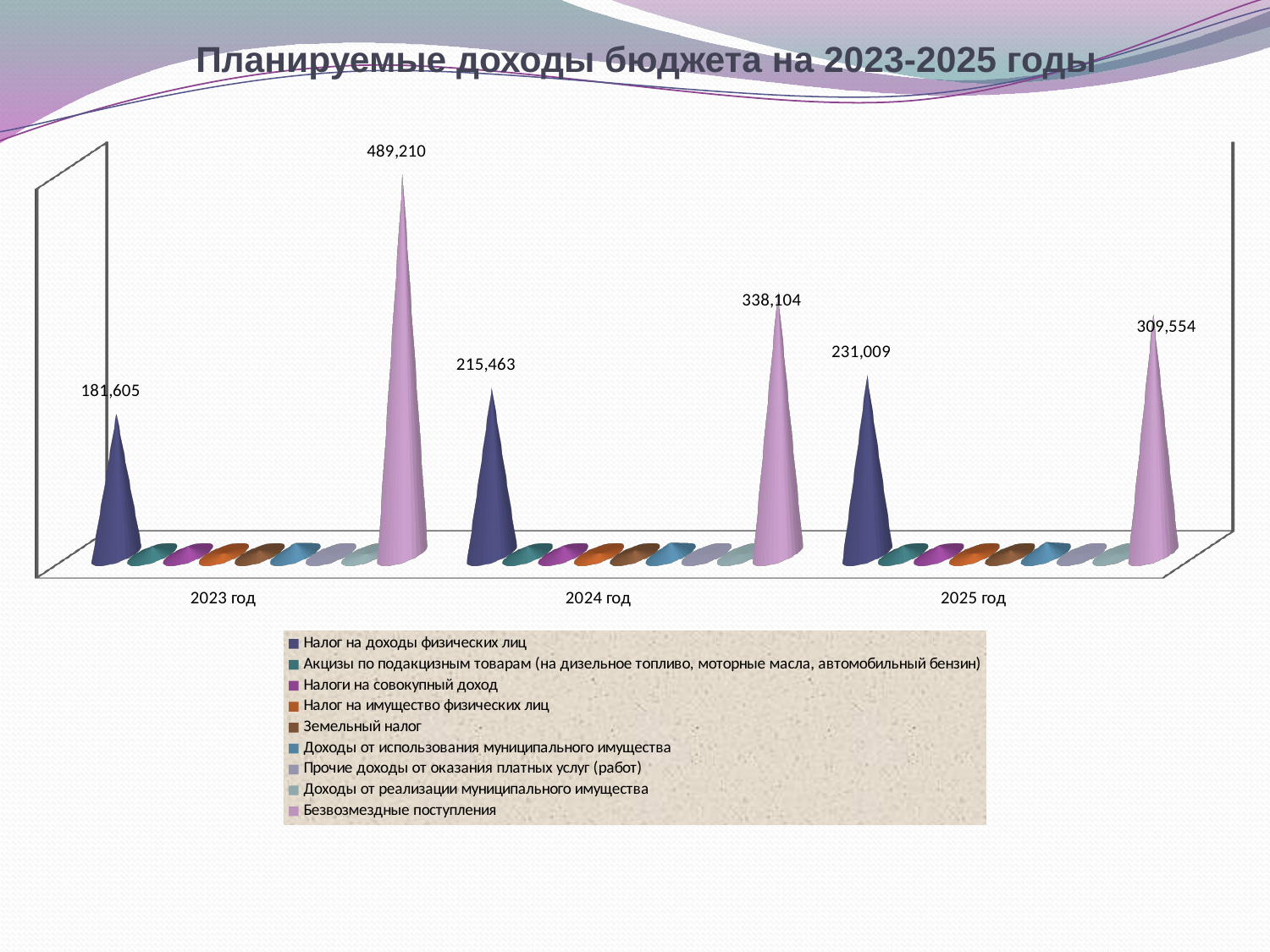
How many years are shown on the x axis? 3 Does Налог на доходы физических лиц rise or fall from 2023 год to 2025 год? rise What is the value of Налог на доходы физических лиц for 2025 год? 231,009 In which year is Налог на доходы физических лиц lowest? 2023 год What is the title of the chart? Планируемые доходы бюджета на 2023-2025 годы What is the value of Безвозмездные поступления for 2024 год? 338,104 What is the value of Безвозмездные поступления for 2025 год? 309,554 What is the value of Налог на доходы физических лиц for 2023 год? 181,605 Which is larger in 2024 год: Налог на доходы физических лиц or Безвозмездные поступления? Безвозмездные поступления How many series does the legend list? 9 What is the difference between Безвозмездные поступления and Налог на доходы физических лиц in 2023 год? 307,605 In which year is Безвозмездные поступления highest? 2023 год